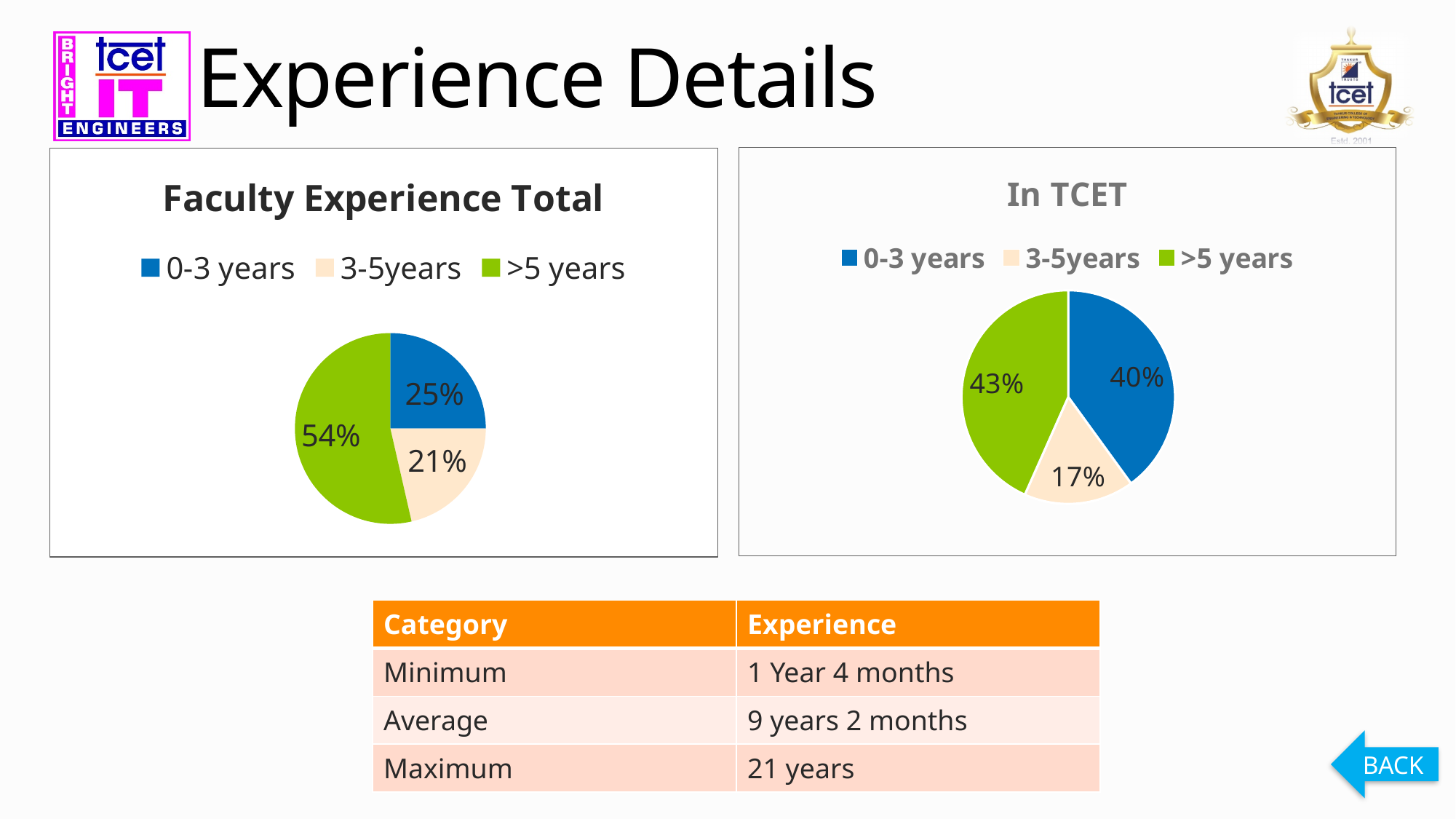
In the 'In TCET' pie chart, which category has the smallest slice? 3-5years In the 'In TCET' pie chart, what share is labelled for the '>5 years' slice? 43% In the 'In TCET' pie chart, what share is labelled for the '0-3 years' slice? 40% In the 'Faculty Experience Total' pie chart, what share is labelled for the '0-3 years' slice? 25% In the 'Faculty Experience Total' pie chart, what share is labelled for the '3-5years' slice? 21% In the 'In TCET' pie chart, what share is labelled for the '3-5years' slice? 17% In the 'In TCET' pie chart, which is larger: the '0-3 years' slice or the '3-5years' slice? 0-3 years In the 'Faculty Experience Total' pie chart, what is the difference in percentage points between the '>5 years' slice and the '0-3 years' slice? 29 In the 'Faculty Experience Total' pie chart, which category has the largest slice? >5 years In the 'Faculty Experience Total' pie chart, what share is labelled for the '>5 years' slice? 54% What type of chart is the 'Faculty Experience Total' chart? Pie chart How many categories does the legend of the 'In TCET' chart list? 3